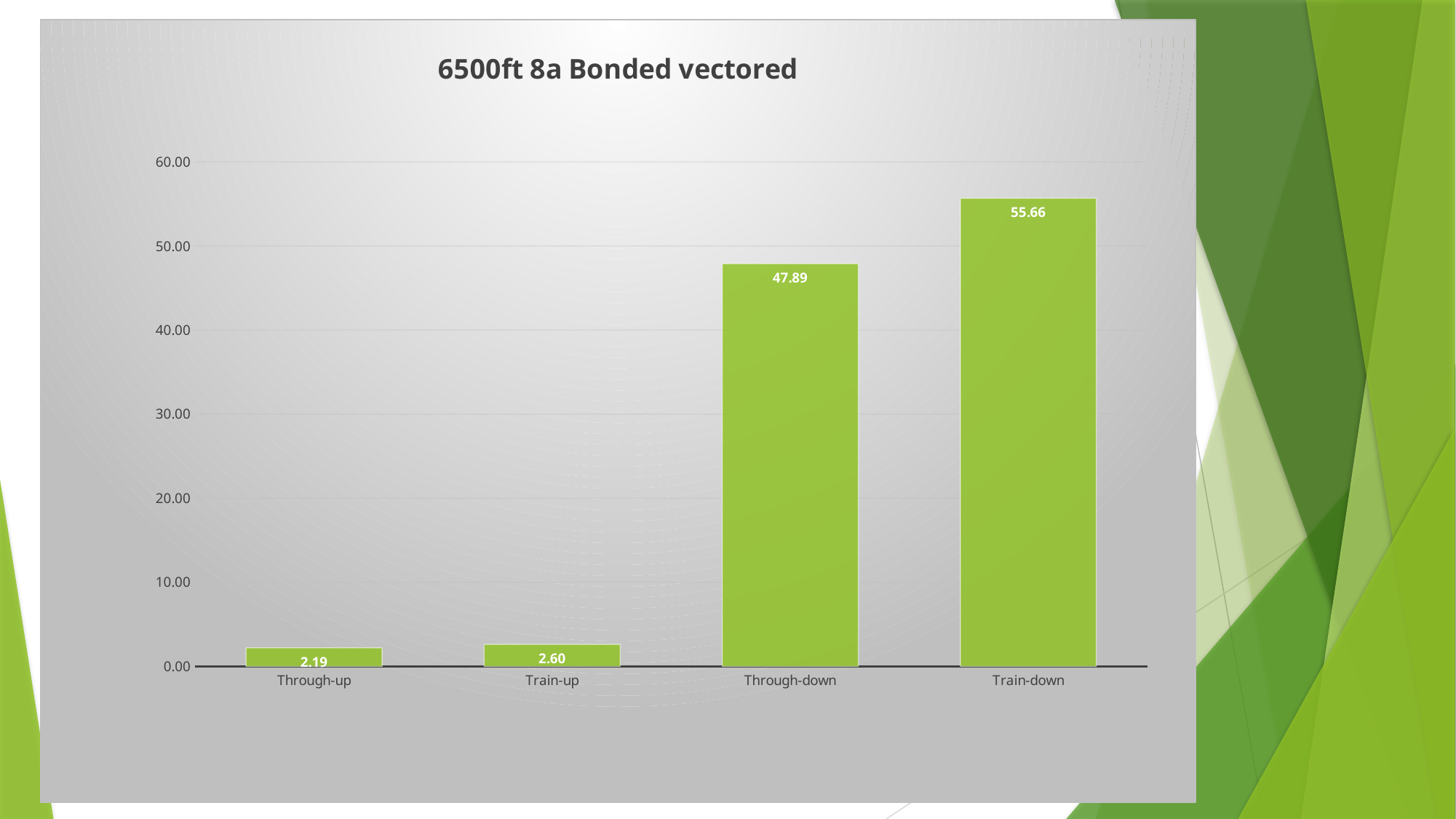
What is the value for Train-up? 2.60 Which category has the lowest value? Through-up Is the value for Through-down greater or less than 40.00? greater What is the title of the chart? 6500ft 8a Bonded vectored How many categories are shown on the x axis? 4 What kind of chart is shown on the slide? Bar chart What is the value for Train-down? 55.66 Which is larger, the value for Through-down or the value for Train-down? Train-down Which category has the highest value? Train-down What is the difference between the values for Train-down and Through-down? 7.77 What is the value for Through-down? 47.89 What is the value for Through-up? 2.19